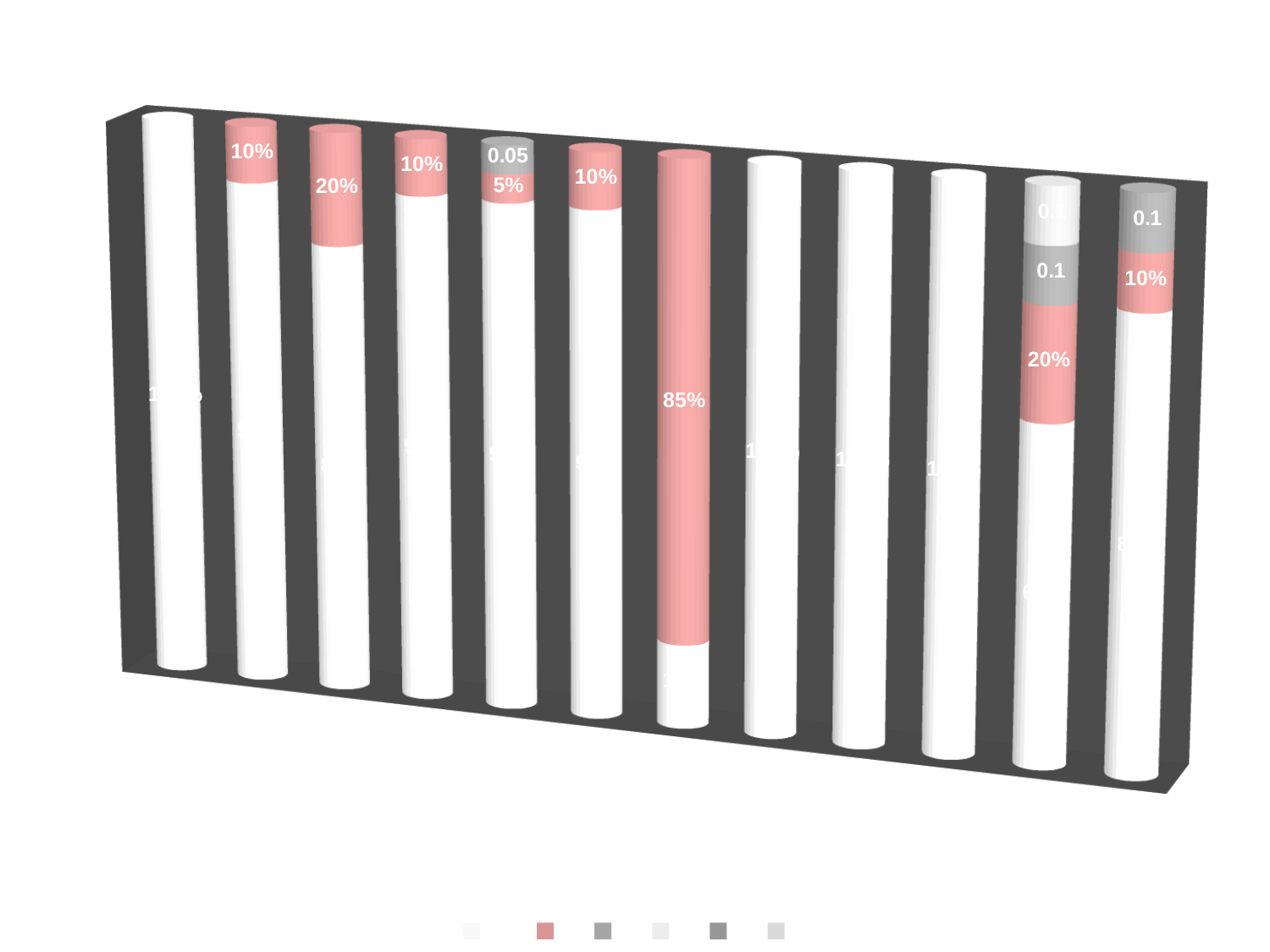
What is the label on the pink segment of the eleventh bar from the left? 20% What is the label on the pink segment of the rightmost bar? 10% What kind of chart is shown on the slide? Stacked bar chart How many bars are plotted in the chart? 12 What is the label on the pink segment of the seventh bar from the left? 85% Which bar has the largest pink segment? The seventh bar from the left (85%) How many series does the legend list? 6 What is the label on the pink segment of the third bar from the left? 20% What is the label on the pink segment of the fifth bar from the left? 5% What is the label on the pink segment of the second bar from the left? 10% What is the label on the grey segment at the top of the fifth bar from the left? 0.05 What is the label on the grey segment at the top of the rightmost bar? 0.1